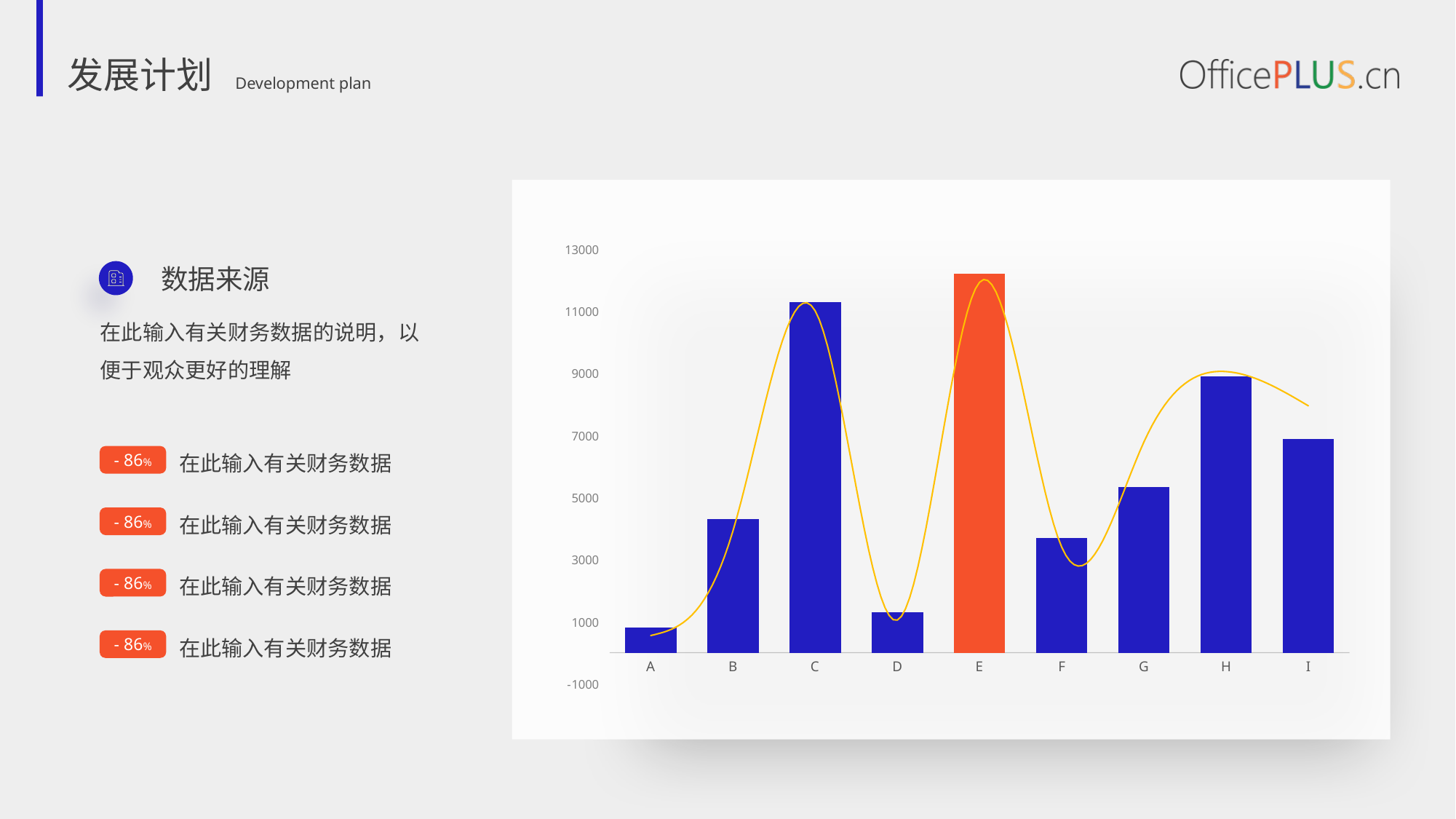
Which category has the highest bar in the chart? E Which bar is taller, B or F? B Is the value for B greater or less than 5000? less Which bar is taller, C or H? C How many categories are shown on the x axis of the chart? 9 Which category's bar is coloured orange instead of blue? E Is the value for H greater or less than 7000? greater Is the value for D greater or less than 3000? less Which bar is taller, G or I? I Which category has the lowest bar in the chart? A What kind of chart is shown on the slide? combination bar and line chart